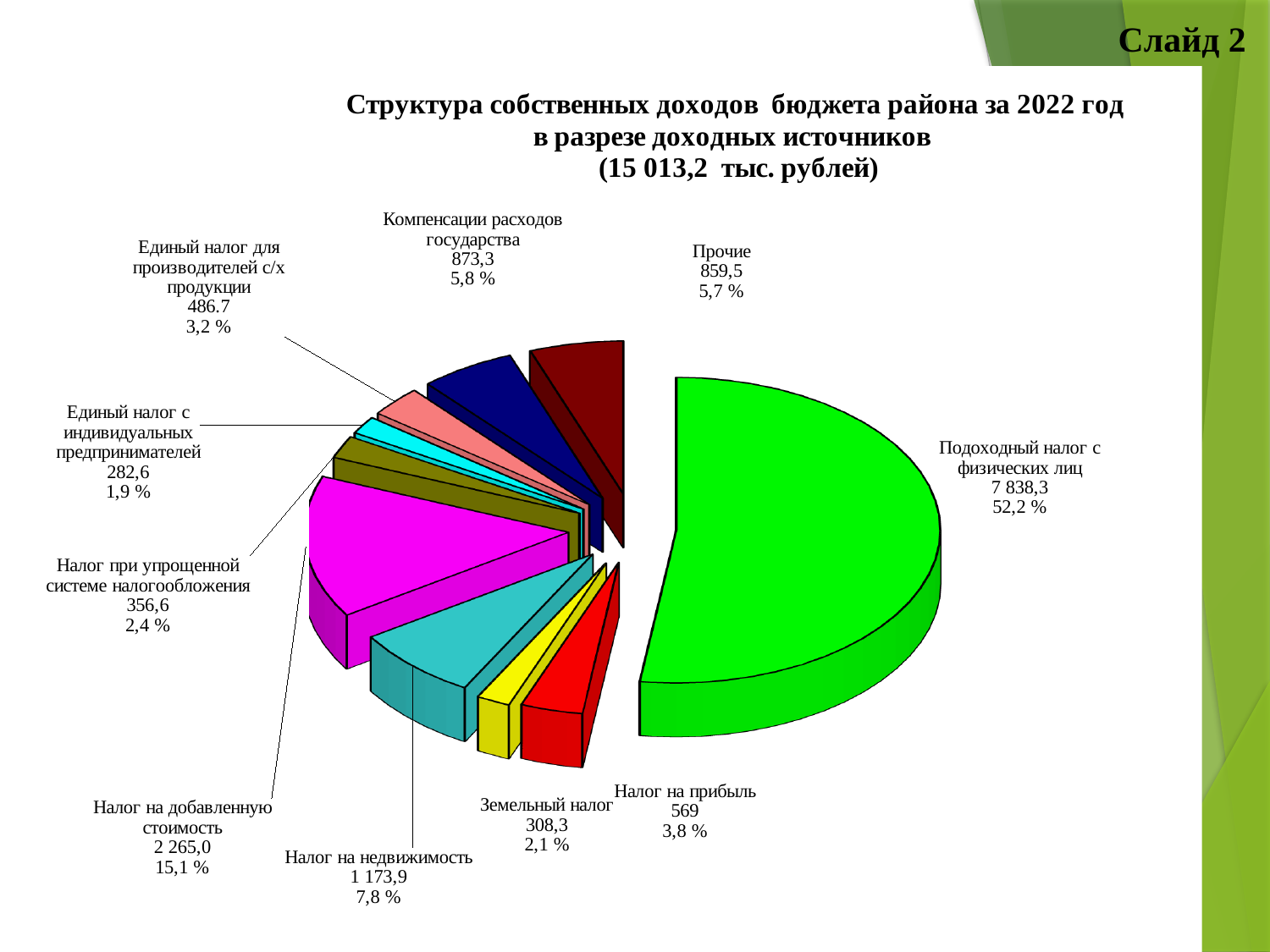
Which category has the largest slice of the pie? Подоходный налог с физических лиц How many categories (slices) does the pie chart show? 10 What is the difference between the values for Налог на добавленную стоимость and Налог на недвижимость? 1 091,1 What is the value shown for Налог на прибыль? 569 What total amount in thousand rubles is stated in the chart title? 15 013,2 тыс. рублей What share of the pie does Налог на добавленную стоимость account for? 15,1 % Which is larger: Компенсации расходов государства or Прочие? Компенсации расходов государства What is the value shown for Подоходный налог с физических лиц? 7 838,3 Which category has the smallest slice of the pie? Единый налог с индивидуальных предпринимателей What share of the pie does Земельный налог account for? 2,1 % What is the value shown for Налог на недвижимость? 1 173,9 What kind of chart is shown on the slide? Pie chart